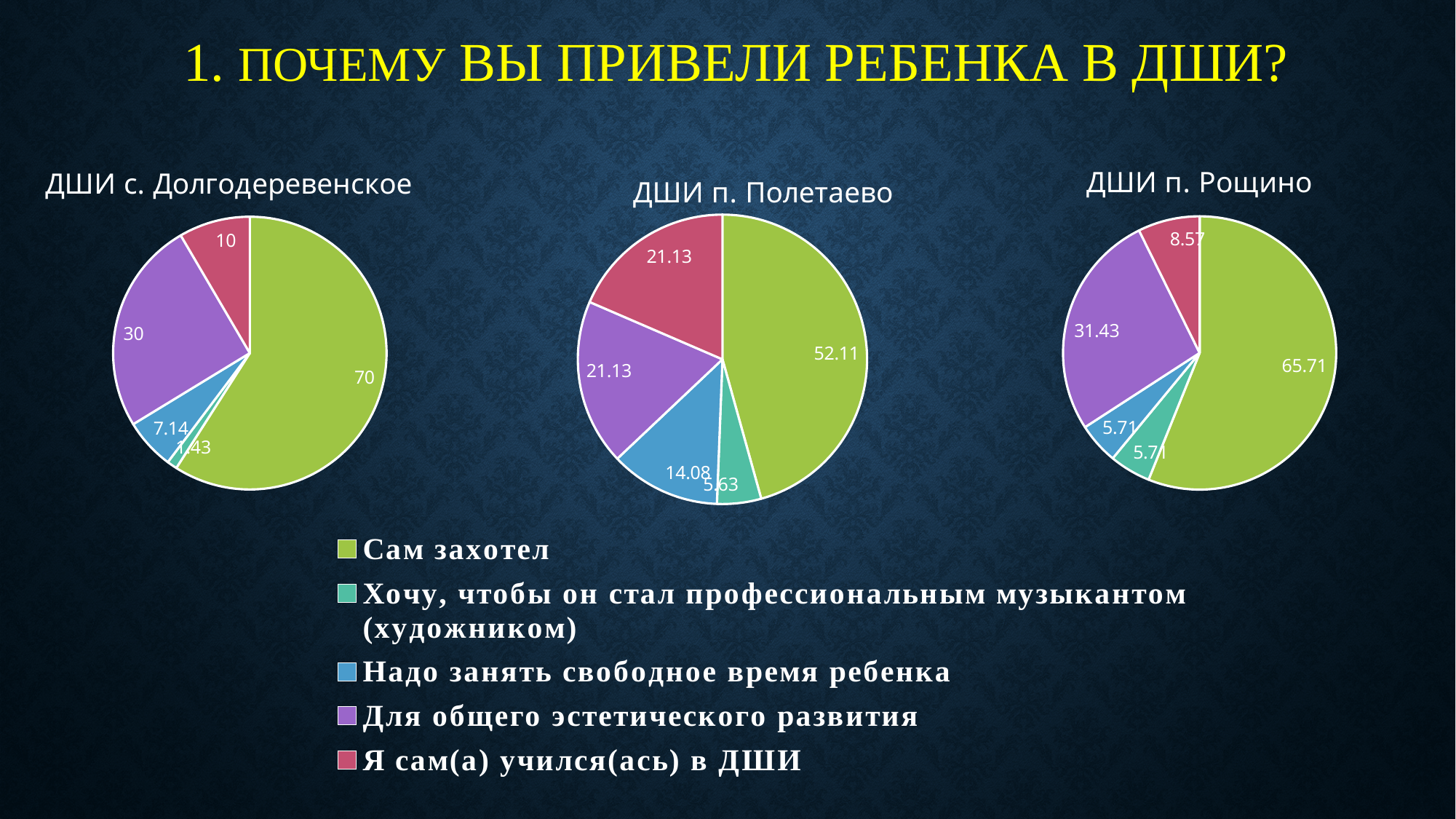
What kind of chart is the chart titled "ДШИ п. Полетаево"? Pie chart How many categories does the legend list for the charts on the slide? 5 In the chart titled "ДШИ с. Долгодеревенское", what is the value for "Сам захотел"? 70 How many pie charts are shown on the slide? 3 In the chart titled "ДШИ п. Рощино", what is the value for "Я сам(а) учился(ась) в ДШИ"? 8.57 In the chart titled "ДШИ п. Полетаево", what is the difference between the values for "Сам захотел" and "Для общего эстетического развития"? 30.98 In the chart titled "ДШИ п. Рощино", what is the value for "Для общего эстетического развития"? 31.43 In the chart titled "ДШИ с. Долгодеревенское", what is the difference between the values for "Для общего эстетического развития" and "Я сам(а) учился(ась) в ДШИ"? 20 In the chart titled "ДШИ п. Рощино", which is larger: the value for "Для общего эстетического развития" or the value for "Я сам(а) учился(ась) в ДШИ"? Для общего эстетического развития In the chart titled "ДШИ с. Долгодеревенское", which category has the smallest slice? Хочу, чтобы он стал профессиональным музыкантом (художником) In the chart titled "ДШИ п. Полетаево", which category has the largest slice? Сам захотел In the chart titled "ДШИ п. Полетаево", what is the value for "Надо занять свободное время ребенка"? 14.08